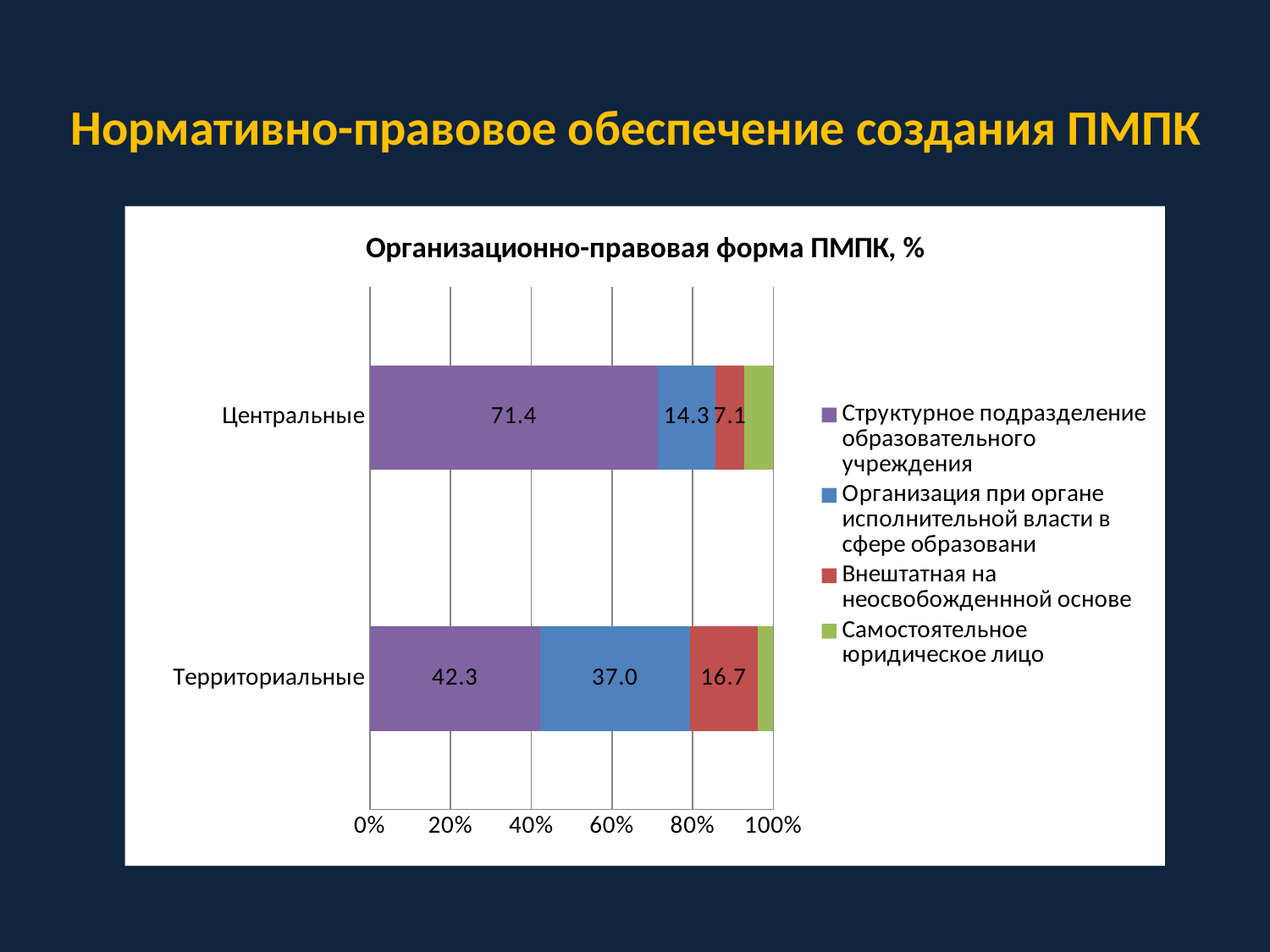
What is the value for Центральные in the Структурное подразделение образовательного учреждения series? 71.4 What is the difference between the Структурное подразделение образовательного учреждения values for Центральные and Территориальные? 29.1 Among the labelled segments of the Территориальные bar, which series has the lowest value? Внештатная на неосвобожденнной основе How many series does the legend list? 4 What is the value for Территориальные in the Организация при органе исполнительной власти в сфере образовани series? 37.0 Is the value for Территориальные in the Самостоятельное юридическое лицо series greater or less than 20%? less Which category has the higher value for Структурное подразделение образовательного учреждения, Центральные or Территориальные? Центральные What is the value for Территориальные in the Внештатная на неосвобожденнной основе series? 16.7 What kind of chart is shown on the slide? Stacked bar chart How many categories are shown on the chart? 2 What is the difference between the Внештатная на неосвобожденнной основе values for Территориальные and Центральные? 9.6 What is the value for Центральные in the Организация при органе исполнительной власти в сфере образовани series? 14.3